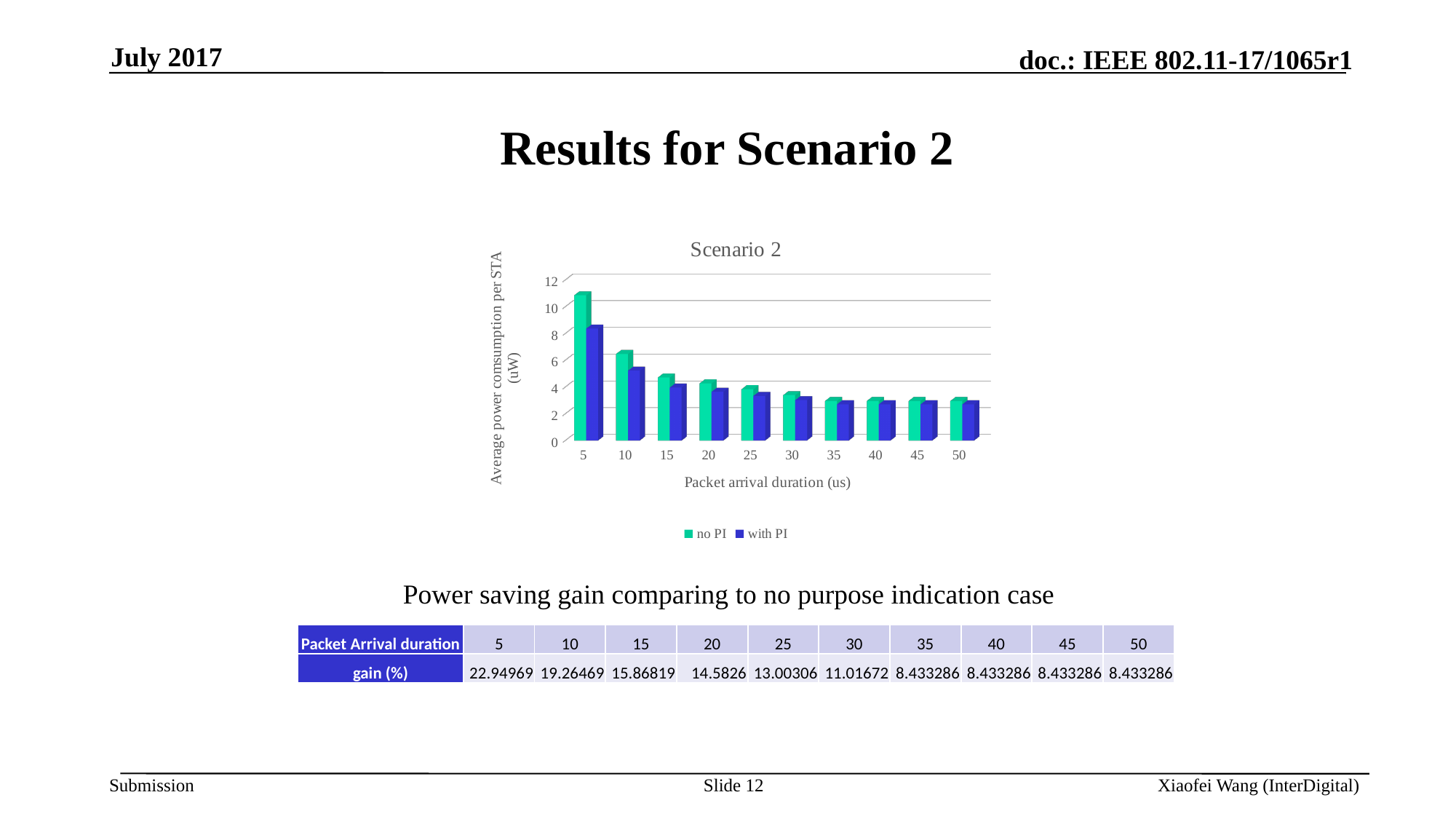
What is the label of the x axis of the chart? Packet arrival duration (us) Is the 'no PI' value at packet arrival duration 10 greater or less than 6? greater Is the 'with PI' value at packet arrival duration 5 greater or less than 10? less How many series does the chart legend list? 2 Is the 'no PI' value at packet arrival duration 5 greater or less than 10? greater What is the title of the chart? Scenario 2 At packet arrival duration 5, which series has the larger value, 'no PI' or 'with PI'? no PI What kind of chart is shown on the slide? bar chart How many packet arrival duration categories are plotted on the x axis? 10 Do the 'no PI' values rise or fall as the packet arrival duration increases from 5 to 50? fall At which packet arrival duration is the 'no PI' value highest? 5